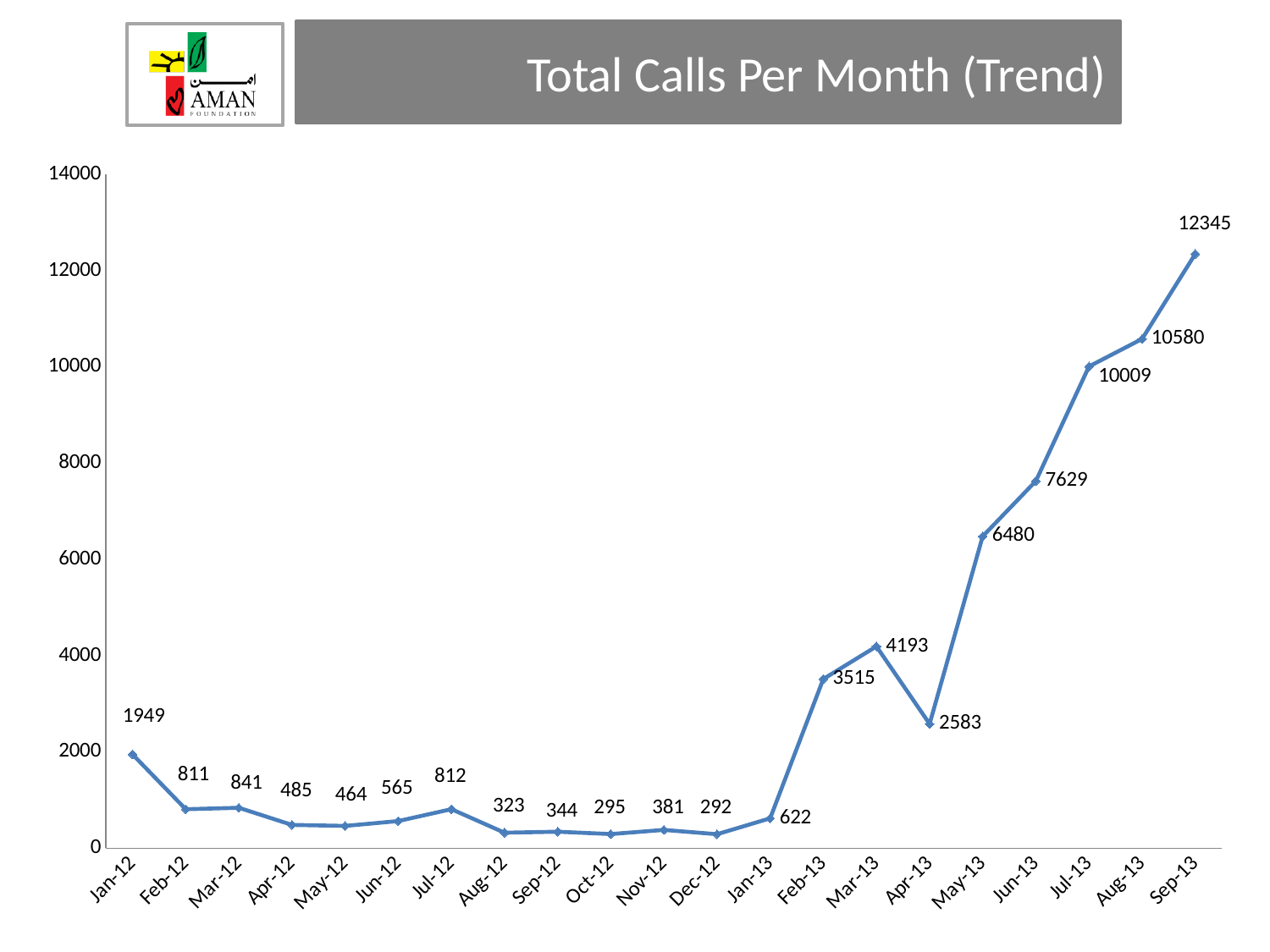
Which month has the highest number of calls? Sep-13 What is the value for Apr-13? 2583 What is the value for Jan-12? 1949 How many months are plotted on the chart? 21 Is the value for Jun-13 greater or less than 8000? less Which month has the lowest number of calls? Dec-12 What kind of chart is shown on the slide? line chart What is the difference between the values for Mar-13 and Apr-13? 1610 What is the title of the chart? Total Calls Per Month (Trend) Which is larger, the value for Jul-12 or the value for Feb-12? Jul-12 What is the total number of calls in Sep-13? 12345 What is the difference between the values for Sep-13 and Aug-13? 1765